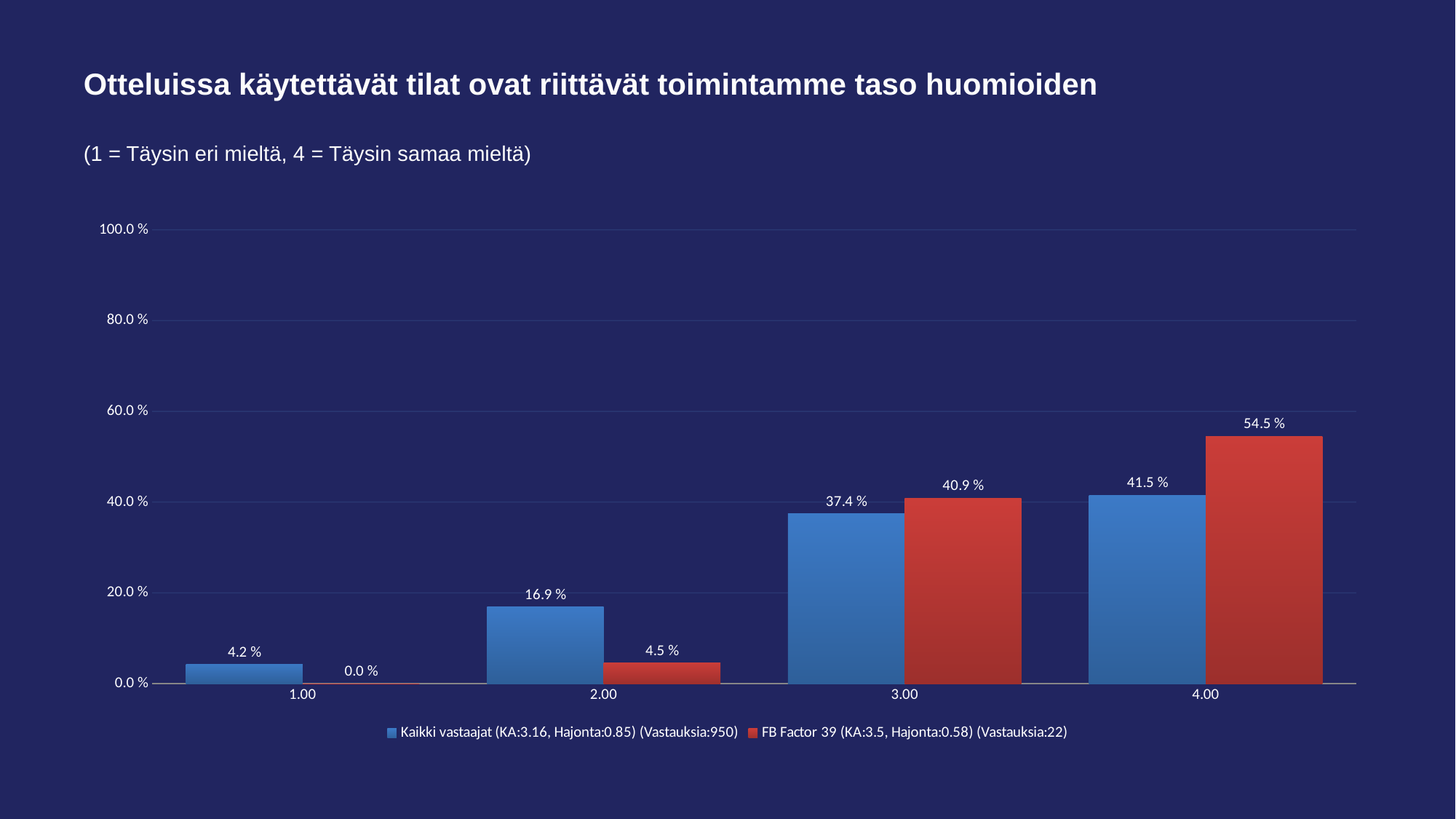
How many categories are shown on the x axis? 4 At 2.00, which series has the larger value, Kaikki vastaajat or FB Factor 39? Kaikki vastaajat What is the difference between the Kaikki vastaajat and FB Factor 39 values at 4.00? 13.0 % What is the value for Kaikki vastaajat at 3.00? 37.4 % Do the values for FB Factor 39 rise or fall from 1.00 to 4.00? Rise Which category has the highest value for FB Factor 39? 4.00 Which category has the lowest value for Kaikki vastaajat? 1.00 What is the value for FB Factor 39 at 2.00? 4.5 % What is the value for Kaikki vastaajat at 1.00? 4.2 % What is the value for FB Factor 39 at 4.00? 54.5 % What kind of chart is shown on the slide? Bar chart How many series does the legend list? 2